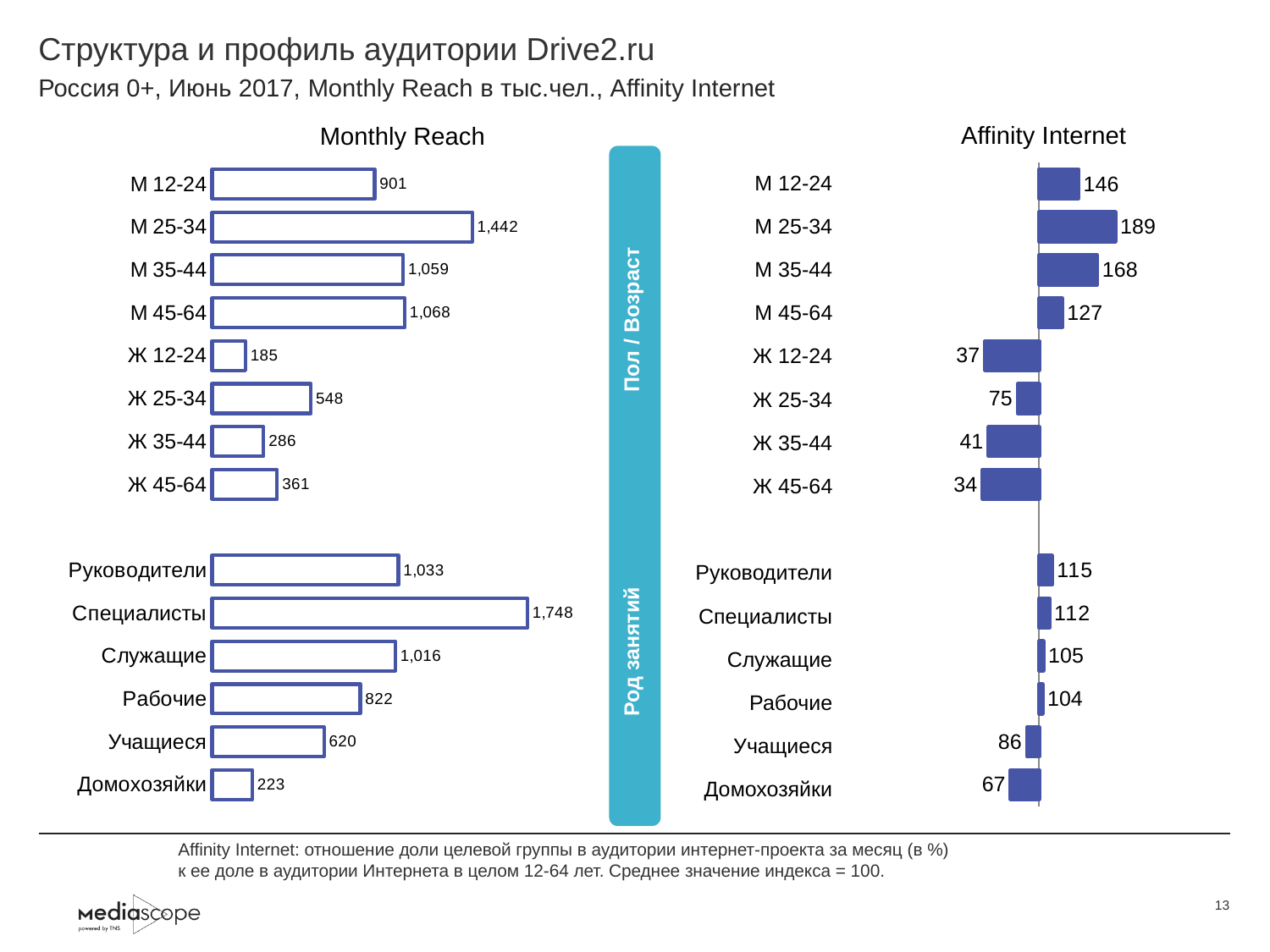
In the Monthly Reach chart, what is the value for М 25-34? 1,442 In the Affinity Internet chart, which category has the lowest value? Ж 45-64 What kind of chart is the Monthly Reach chart? Bar chart In the Monthly Reach chart, what is the difference between the values for Специалисты and Руководители? 715 In the Affinity Internet chart, which is larger: the value for М 35-44 or the value for М 45-64? М 35-44 In the Affinity Internet chart, what is the difference between the values for М 25-34 and Ж 25-34? 114 In the Monthly Reach chart, which category has the highest value? Специалисты In the Affinity Internet chart, what is the value for Рабочие? 104 In the Monthly Reach chart, what is the value for Домохозяйки? 223 In the Affinity Internet chart, what is the value for Ж 12-24? 37 In the Monthly Reach chart, which is larger: the value for Ж 25-34 or the value for Ж 45-64? Ж 25-34 How many categories are plotted in the Affinity Internet chart? 14